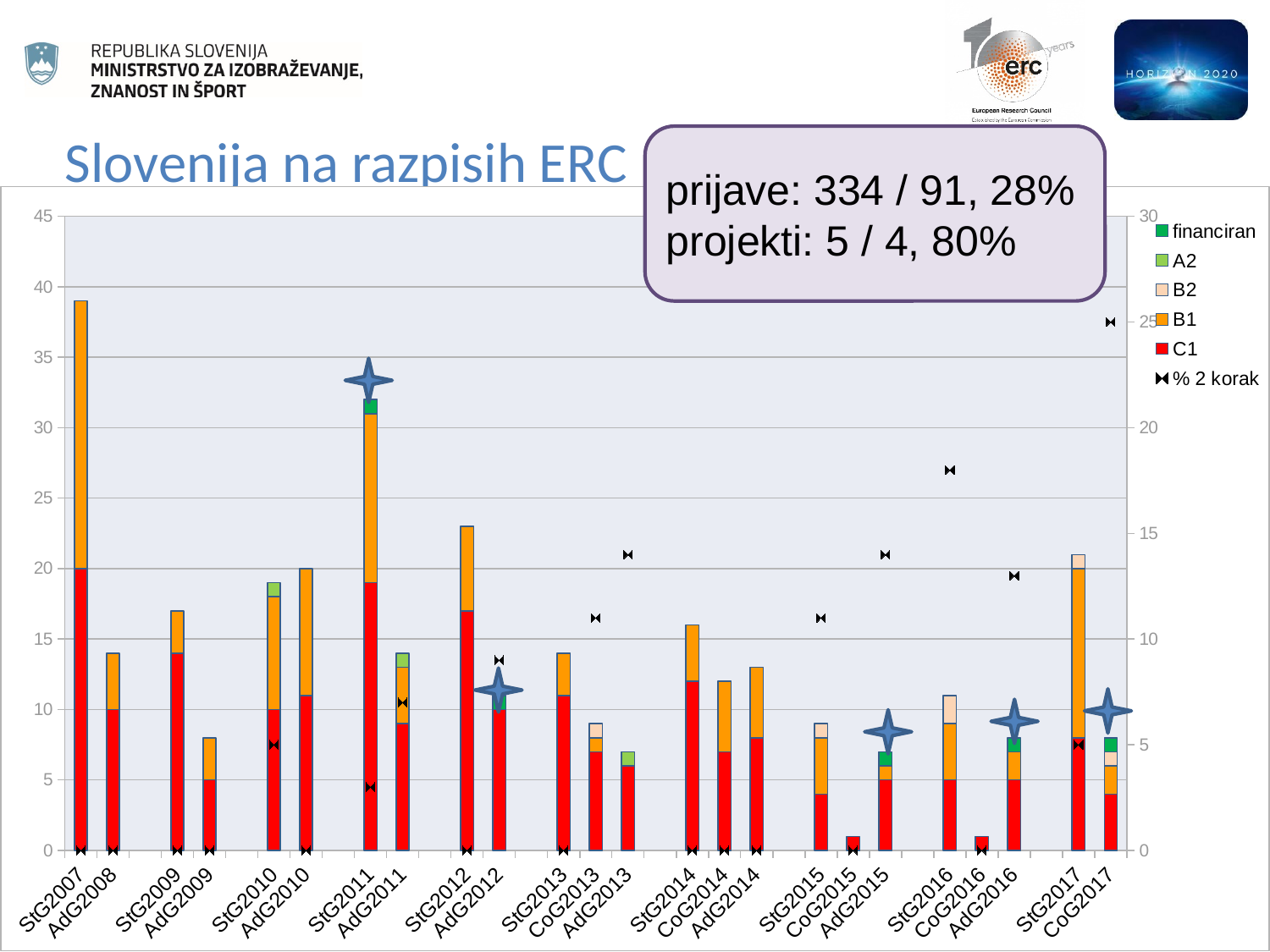
How many categories are shown along the x axis of the chart? 24 Is the total height of the CoG2017 bar greater or less than 10? less Is the total height of the StG2007 bar greater or less than 35? greater Is the total height of the StG2012 bar greater or less than 20? greater Which category has the tallest stacked bar in the chart? StG2007 Which stacked bar is taller, StG2007 or StG2011? StG2007 How many series does the chart legend list? 6 Which stacked bar is taller, StG2012 or AdG2010? StG2012 What is the title of the slide containing the chart? Slovenija na razpisih ERC What kind of chart is shown on the slide? bar chart